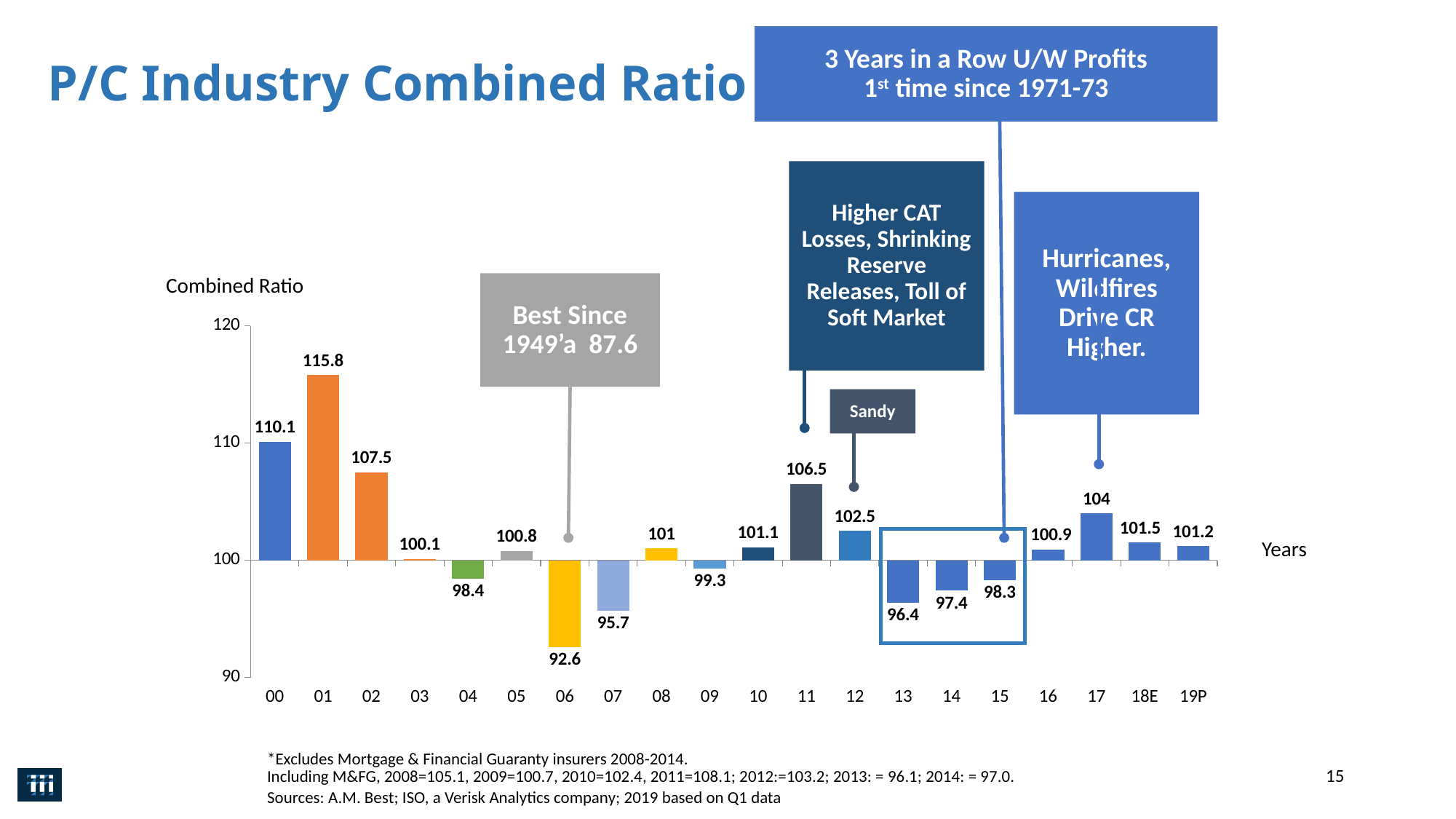
Which year has a higher combined ratio, 13 or 14? 14 What kind of chart is shown on the slide? bar chart What is the combined ratio for 2006 (06)? 92.6 How many years are shown on the x axis? 20 What is the difference between the combined ratio for 11 and for 12? 4.0 Which year has the highest combined ratio? 01 Is the combined ratio for 07 greater or less than 100? less Do the combined ratio values rise or fall from 13 to 15? rise What is the combined ratio for 2001 (01)? 115.8 What is the combined ratio for 2017 (17)? 104 Which year has the lowest combined ratio? 06 What is the difference between the combined ratio for 01 and for 00? 5.7